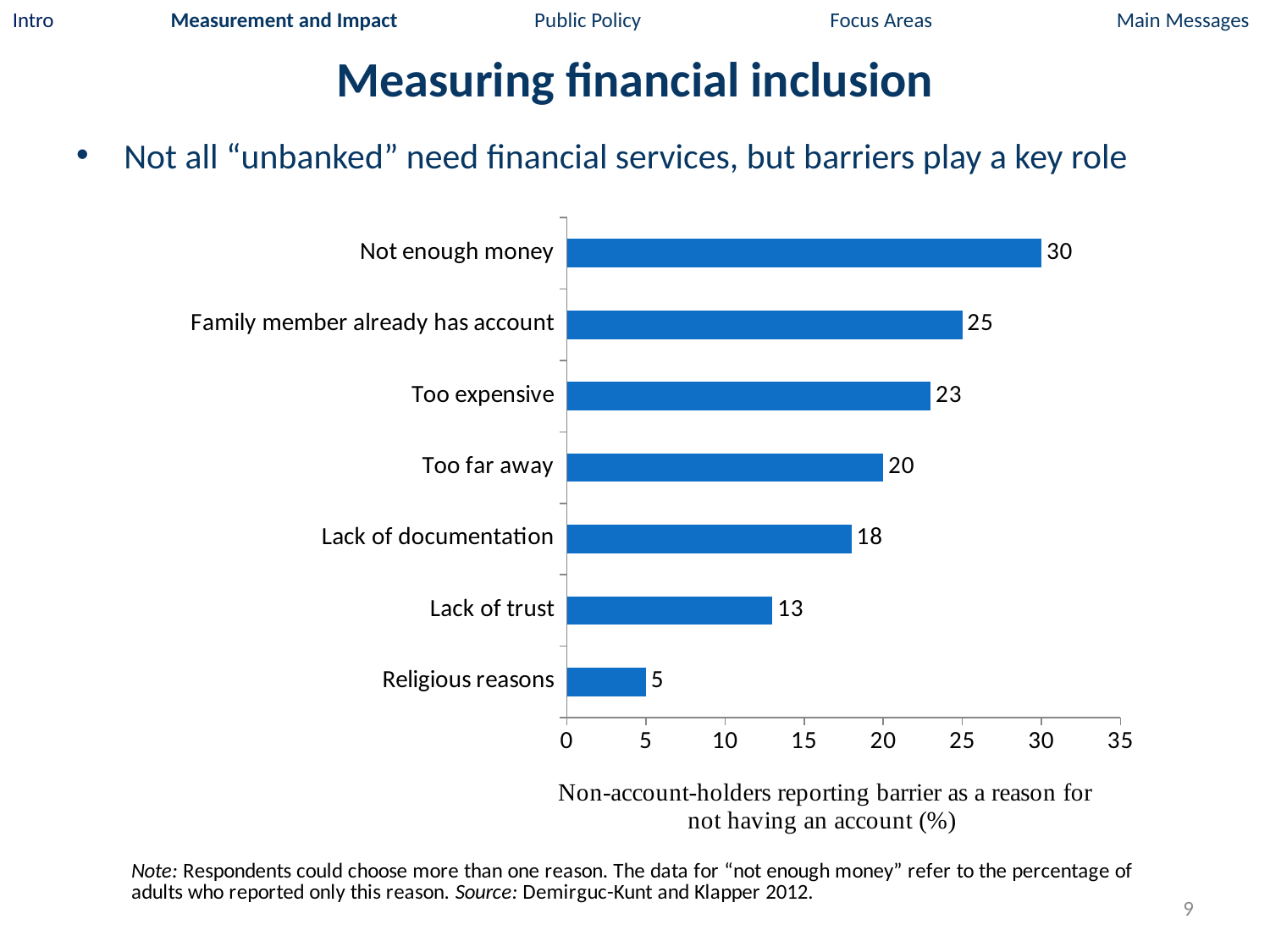
Which is larger, the value for 'Too expensive' or the value for 'Too far away'? Too expensive How many barriers (categories) are shown in the chart? 7 Which barrier has the highest value in the chart? Not enough money What percentage of non-account-holders reported 'Not enough money' as a reason for not having an account? 30 What kind of chart is shown on the slide? Bar chart Which barrier has the lowest value in the chart? Religious reasons Is the value for 'Lack of documentation' greater or less than 15? greater What value is shown for 'Too far away'? 20 What is the axis label shown below the chart? Non-account-holders reporting barrier as a reason for not having an account (%) What is the difference between the values for 'Lack of documentation' and 'Religious reasons'? 13 What value is shown for 'Lack of trust'? 13 What is the difference between the values for 'Family member already has account' and 'Too expensive'? 2